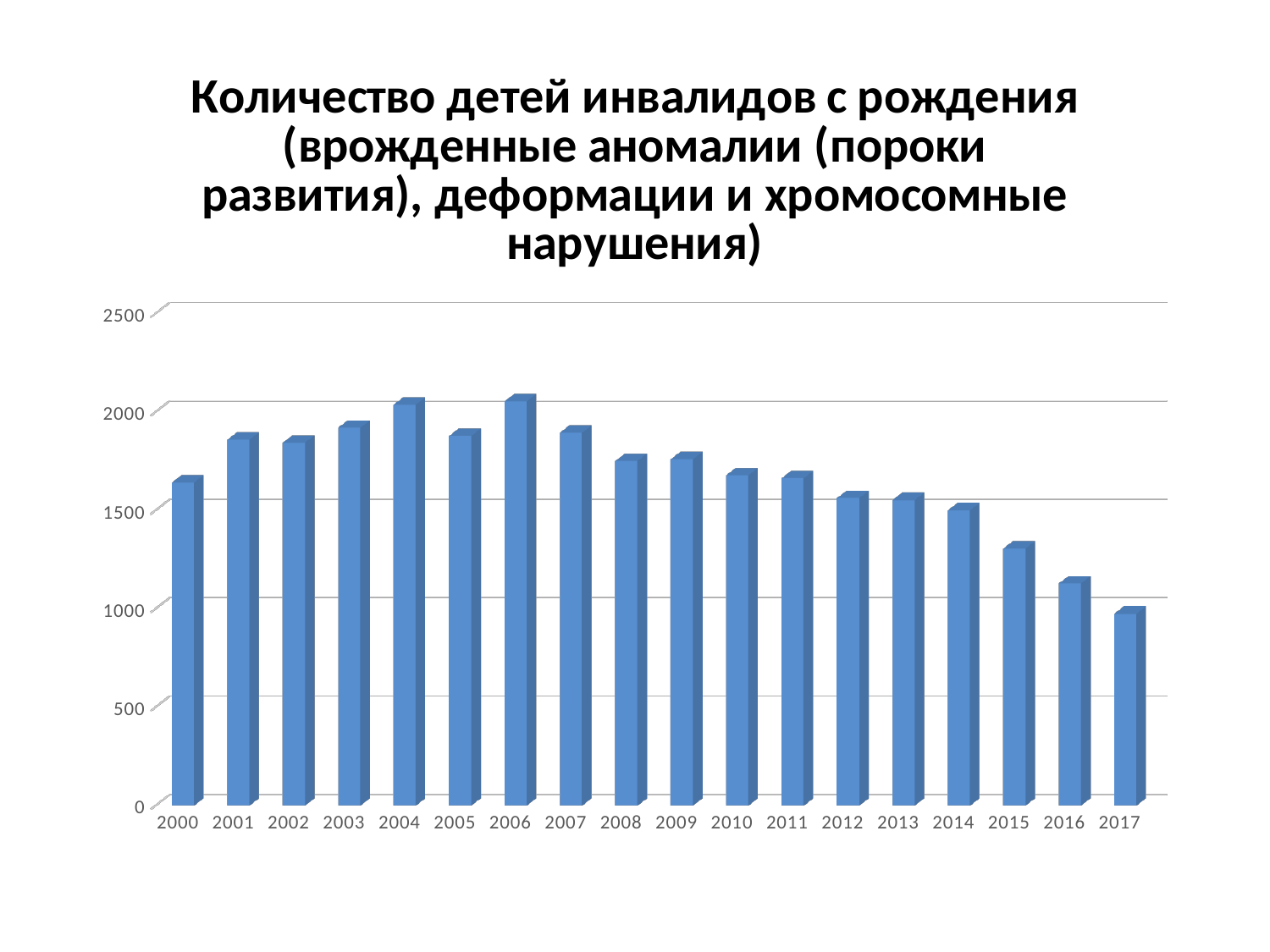
How many years are shown on the x axis of the chart? 18 Is the value for 2000 greater or less than 1500? greater What kind of chart is shown on the slide? bar chart Do the values rise or fall from 2007 to 2017? fall What is the first year shown on the x axis of the chart? 2000 Which year has the lowest value in the chart? 2017 Is the value for 2016 greater or less than 1000? greater Which year has the larger value, 2000 or 2001? 2001 Is the value for 2015 greater or less than 1500? less Which year has the larger value, 2015 or 2016? 2015